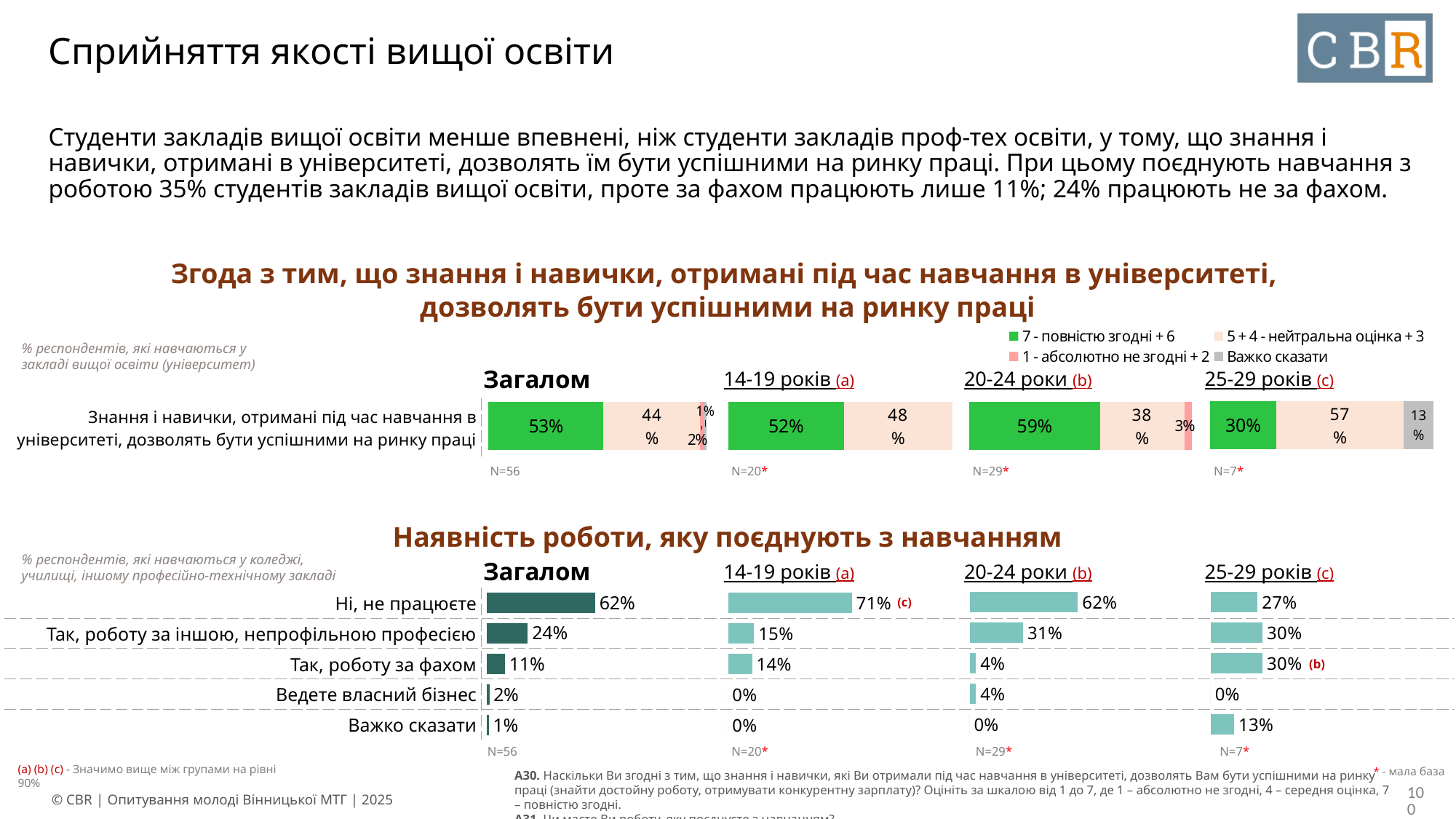
In the bottom chart 'Наявність роботи, яку поєднують з навчанням', what is the difference between the Загалом values for 'Ні, не працюєте' and 'Так, роботу за іншою, непрофільною професією'? 38 percentage points How many categories are shown in the bottom chart 'Наявність роботи, яку поєднують з навчанням'? 5 In the bottom chart 'Наявність роботи, яку поєднують з навчанням', which category has the highest Загалом value? Ні, не працюєте In the top chart 'Згода з тим, що знання і навички...', what is the value of '7 - повністю згодні + 6' for the Загалом group? 53% In the bottom chart 'Наявність роботи, яку поєднують з навчанням', what is the value of 'Ні, не працюєте' for the 14-19 років group? 71% In the bottom chart 'Наявність роботи, яку поєднують з навчанням', what is the Загалом value for 'Так, роботу за фахом'? 11% In the top chart 'Згода з тим, що знання і навички...', what is the 'Важко сказати' value for the 25-29 років group? 13% In the top chart 'Згода з тим, що знання і навички...', which age group has the highest share of '7 - повністю згодні + 6'? 20-24 роки In the bottom chart 'Наявність роботи, яку поєднують з навчанням', which group has the larger value for 'Так, роботу за фахом': 14-19 років or 20-24 роки? 14-19 років How many series does the legend of the top chart 'Згода з тим, що знання і навички...' list? 4 What kind of chart is the bottom chart 'Наявність роботи, яку поєднують з навчанням'? Bar chart In the top chart 'Згода з тим, що знання і навички...', what is the difference between the '7 - повністю згодні + 6' values for 20-24 роки and 25-29 років? 29 percentage points